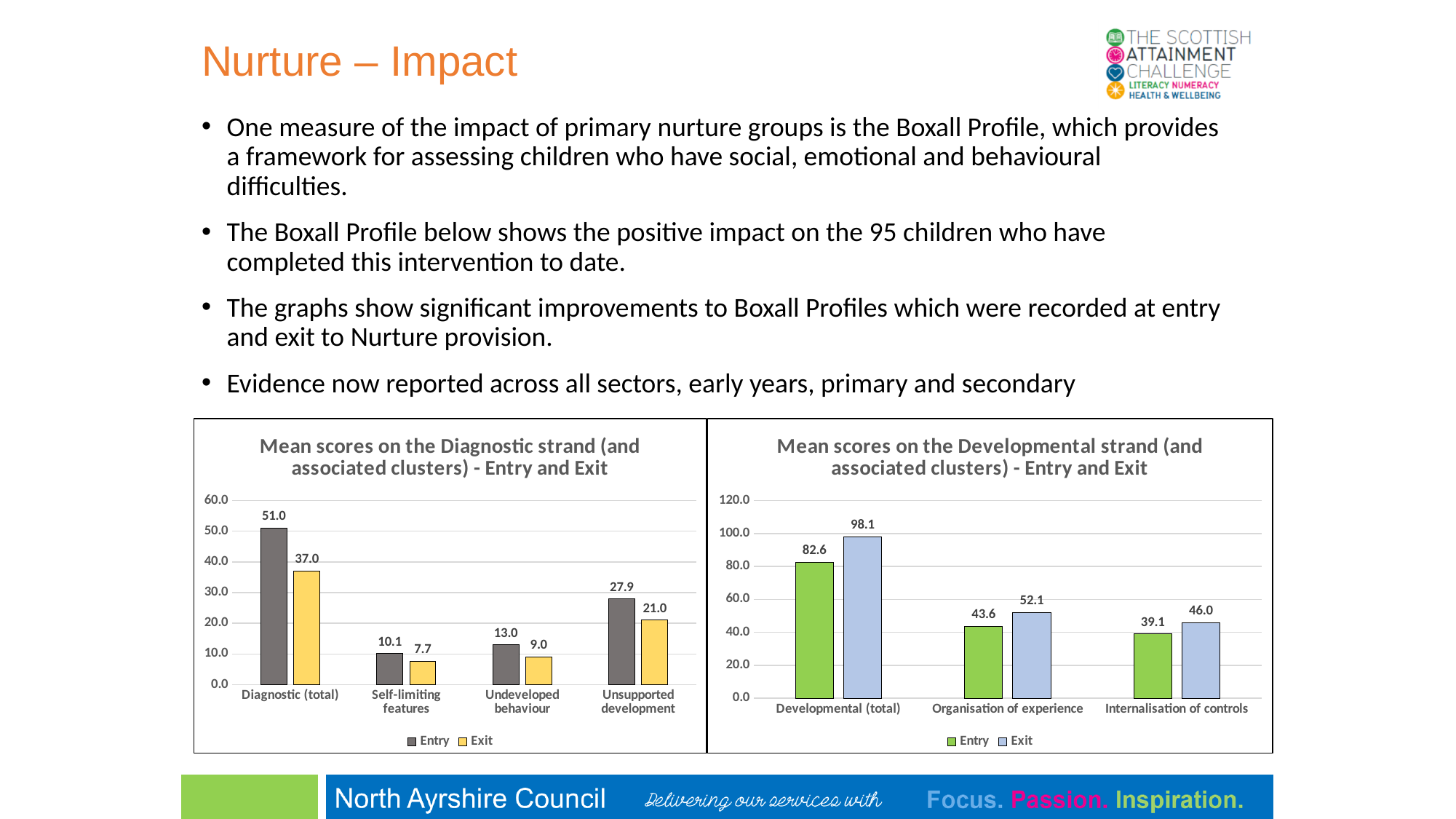
In the Developmental strand chart, what is the Entry mean score for Internalisation of controls? 39.1 In the Developmental strand chart, what is the difference between the Exit and Entry scores for Organisation of experience? 8.5 How many categories are shown on the x axis of the Developmental strand chart? 3 In the Diagnostic strand chart, what is the difference between the Entry and Exit scores for Unsupported development? 6.9 In the Diagnostic strand chart, which category has the lowest Exit score? Self-limiting features In the Diagnostic strand chart, what is the Entry mean score for Diagnostic (total)? 51.0 In the Diagnostic strand chart, is the Entry score for Undeveloped behaviour higher or lower than its Exit score? higher In the Developmental strand chart, which category has the highest Entry score? Developmental (total) What type of chart is the Developmental strand chart? bar chart How many series does the legend of the Diagnostic strand chart list? 2 In the Developmental strand chart, what is the Exit mean score for Developmental (total)? 98.1 In the Diagnostic strand chart, what is the Exit mean score for Self-limiting features? 7.7